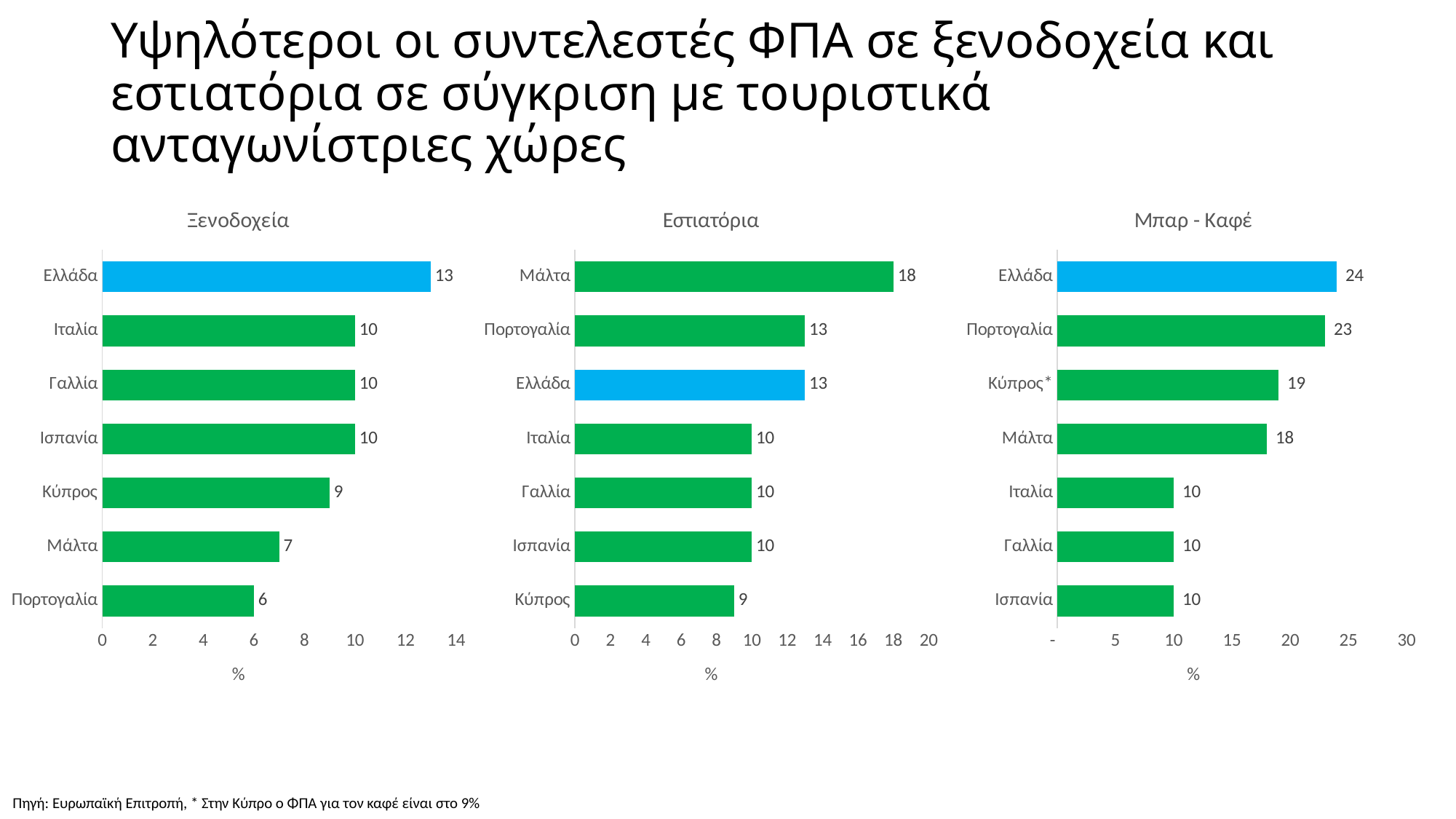
In the Μπαρ - Καφέ chart, is the value for Πορτογαλία greater or less than 20? greater In the Ξενοδοχεία chart, what is the difference between Ελλάδα and Μάλτα? 6 In the Εστιατόρια chart, how many countries are shown? 7 In the Εστιατόρια chart, which country has the highest value? Μάλτα In the Εστιατόρια chart, which country's bar is coloured blue? Ελλάδα What kind of chart is the Ξενοδοχεία chart? bar chart In the Μπαρ - Καφέ chart, which is larger, Κύπρος* or Μάλτα? Κύπρος* In the Ξενοδοχεία chart, which country has the lowest value? Πορτογαλία In the Μπαρ - Καφέ chart, what is the difference between Ελλάδα and Ισπανία? 14 In the Εστιατόρια chart, what is the value for Κύπρος? 9 In the Ξενοδοχεία chart, what is the value for Ελλάδα? 13 In the Μπαρ - Καφέ chart, what is the value for Ελλάδα? 24